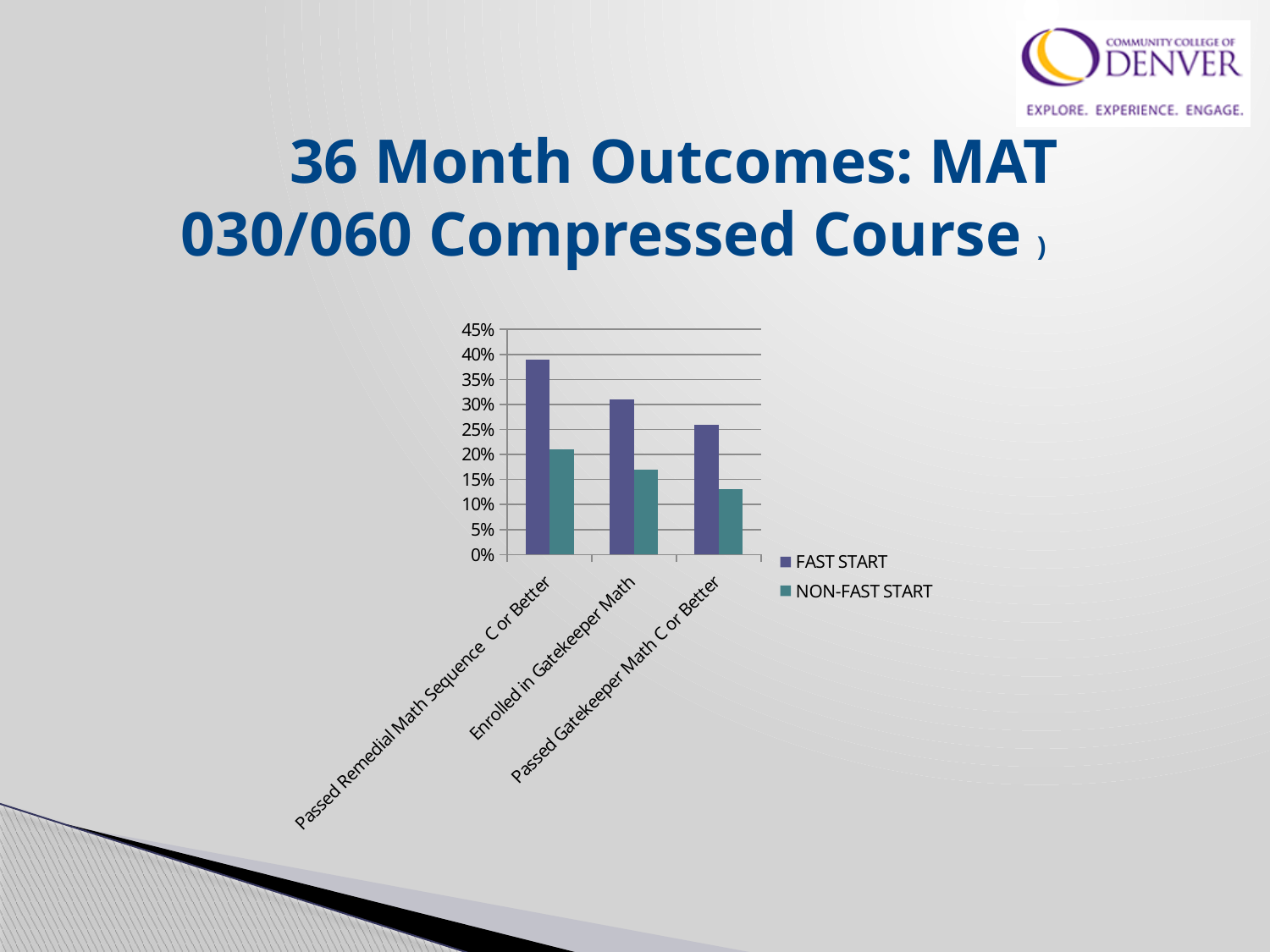
Which category has the lowest NON-FAST START value? Passed Gatekeeper Math C or Better Is the NON-FAST START value for Passed Gatekeeper Math C or Better greater or less than 15%? less What kind of chart is shown on the slide? bar chart Which series is shown in purple in the chart legend? FAST START How many series does the chart legend list? 2 Is the FAST START value for Passed Remedial Math Sequence C or Better greater or less than 35%? greater What is the highest percentage shown on the chart's y axis? 45% How many outcome categories are shown on the x axis of the chart? 3 Is the FAST START value for Enrolled in Gatekeeper Math greater or less than 25%? greater Which category has the highest FAST START value? Passed Remedial Math Sequence C or Better Do the FAST START values rise or fall moving from left to right across the categories? fall Which series has the higher value for Enrolled in Gatekeeper Math, FAST START or NON-FAST START? FAST START